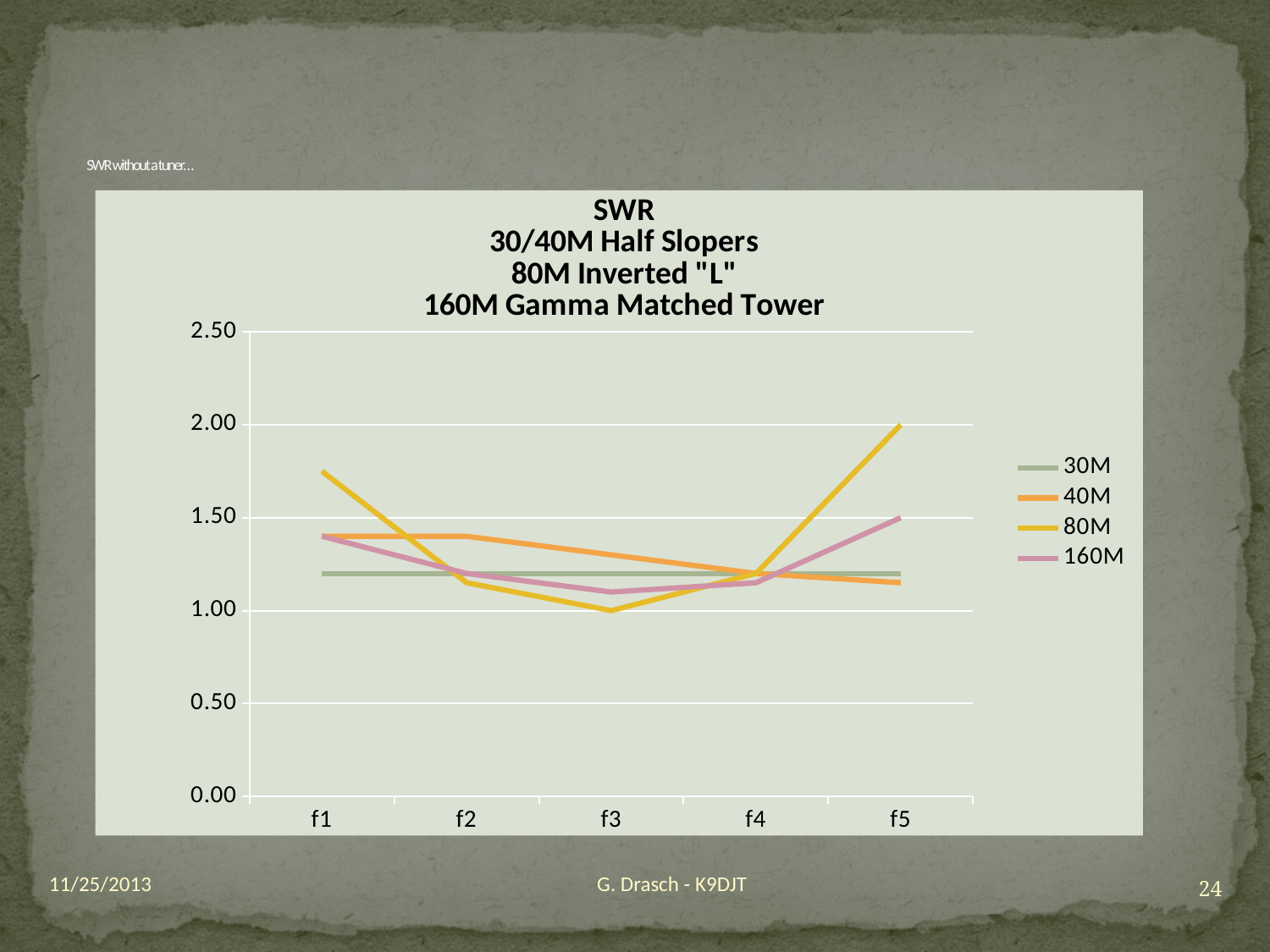
Is the value for 80M at f1 greater or less than 1.50? greater Is the value for 30M at f3 greater or less than 1.50? less Which series has the lowest value at f3? 80M Does the 40M series rise or fall from f2 to f5? fall What is the value for 80M at f5? 2.00 At f1, which is larger: the value for 80M or the value for 40M? 80M Which series has the highest value at f5? 80M How many points are there along the x axis? 5 How many series does the legend list? 4 What are the legend entries of the chart? 30M, 40M, 80M, 160M What kind of chart is shown on the slide? line chart Does the 80M series rise or fall from f3 to f5? rise